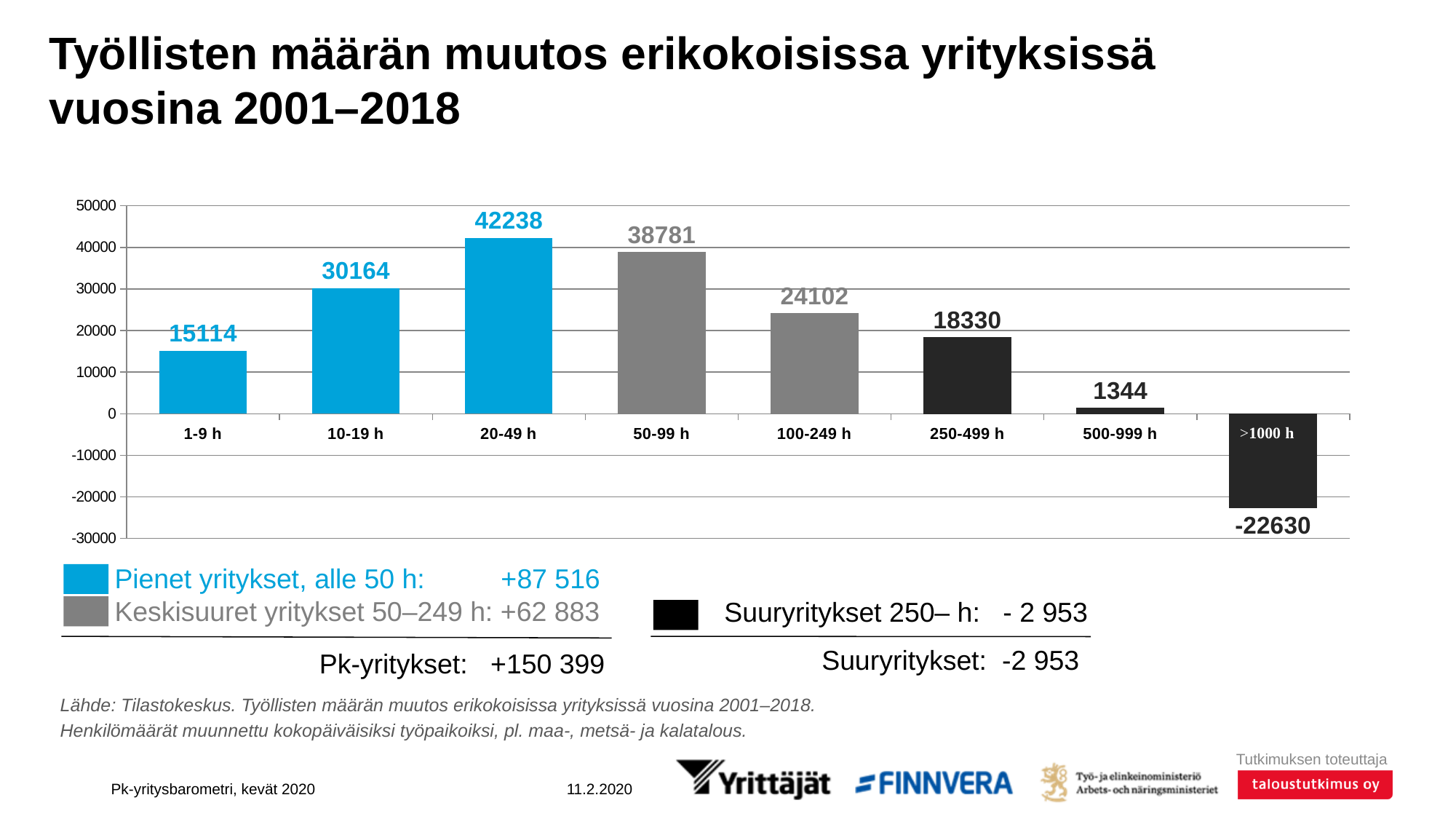
What is the value for the 20-49 h category? 42238 What kind of chart is shown on the slide? bar chart What colour are the bars for the small companies (Pienet yritykset, alle 50 h)? blue Which category has the lowest value? >1000 h Is the value for 1-9 h greater or less than 20000? less What is the value for the >1000 h category? -22630 Which is larger, the value for 10-19 h or the value for 250-499 h? 10-19 h What is the difference between the values for 50-99 h and 100-249 h? 14679 What is the value for the 500-999 h category? 1344 What total is given for Pk-yritykset below the chart? +150 399 Which category has the highest value? 20-49 h How many categories are shown on the x axis? 8